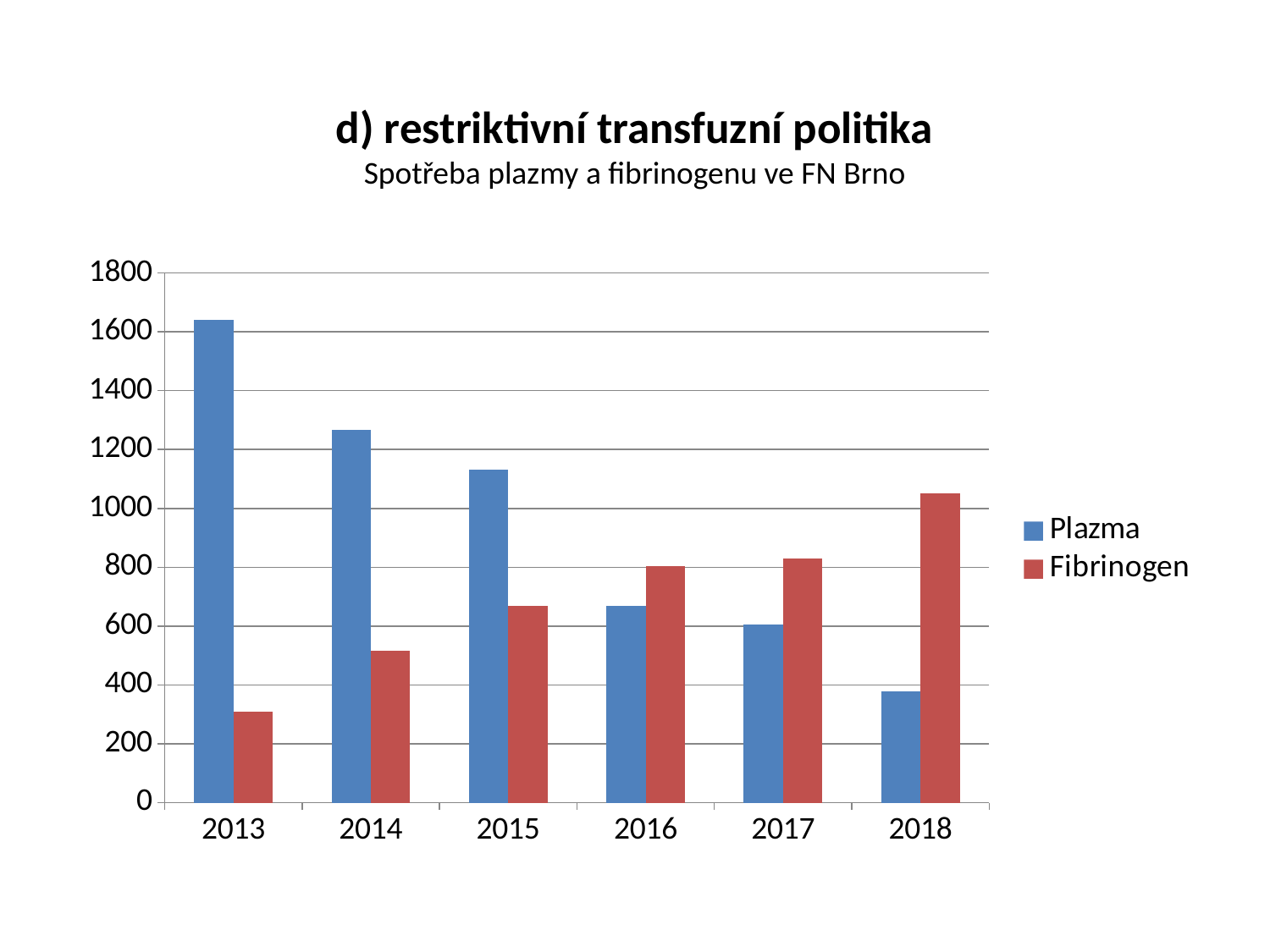
Do the Fibrinogen values rise or fall from 2013 to 2018? rise In which year is the Plazma value lowest? 2018 In 2018, which is larger, Plazma or Fibrinogen? Fibrinogen What kind of chart is shown on the slide? bar chart In which year is the Fibrinogen value highest? 2018 In which year is the Fibrinogen value lowest? 2013 How many series does the legend list? 2 In which year is the Plazma value highest? 2013 How many years are shown on the x axis? 6 Is the Fibrinogen value for 2013 greater or less than 400? less In 2014, which is larger, Plazma or Fibrinogen? Plazma Is the Plazma value for 2013 greater or less than 1400? greater